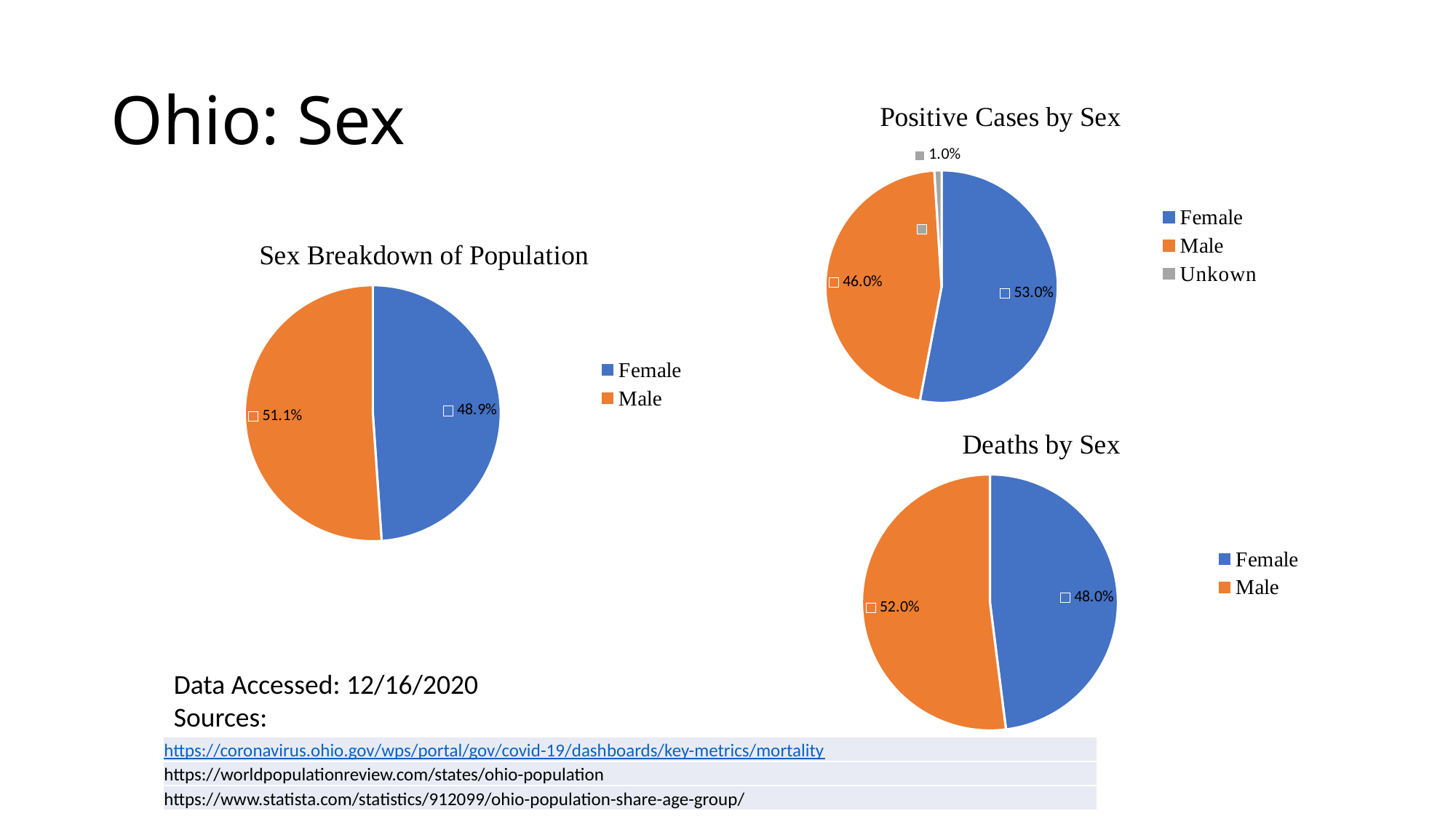
In the 'Positive Cases by Sex' chart, which category has the smallest share? Unkown How many categories does the legend of the 'Positive Cases by Sex' chart list? 3 In the 'Positive Cases by Sex' chart, what percentage of positive cases are Unknown? 1.0% In the 'Positive Cases by Sex' chart, which category has the largest share? Female In the 'Sex Breakdown of Population' chart, which is larger, the Female share or the Male share? Male In the 'Deaths by Sex' chart, what percentage of deaths are Male? 52.0% In the 'Sex Breakdown of Population' chart, what share of the population is Male? 51.1% What type of chart is 'Deaths by Sex'? Pie chart In the 'Deaths by Sex' chart, what is the difference between the Male and Female shares? 4.0% In the 'Positive Cases by Sex' chart, what is the difference between the Female and Male shares? 7.0% In the 'Positive Cases by Sex' chart, what percentage of positive cases are Female? 53.0% In the 'Sex Breakdown of Population' chart, what share of the population is Female? 48.9%